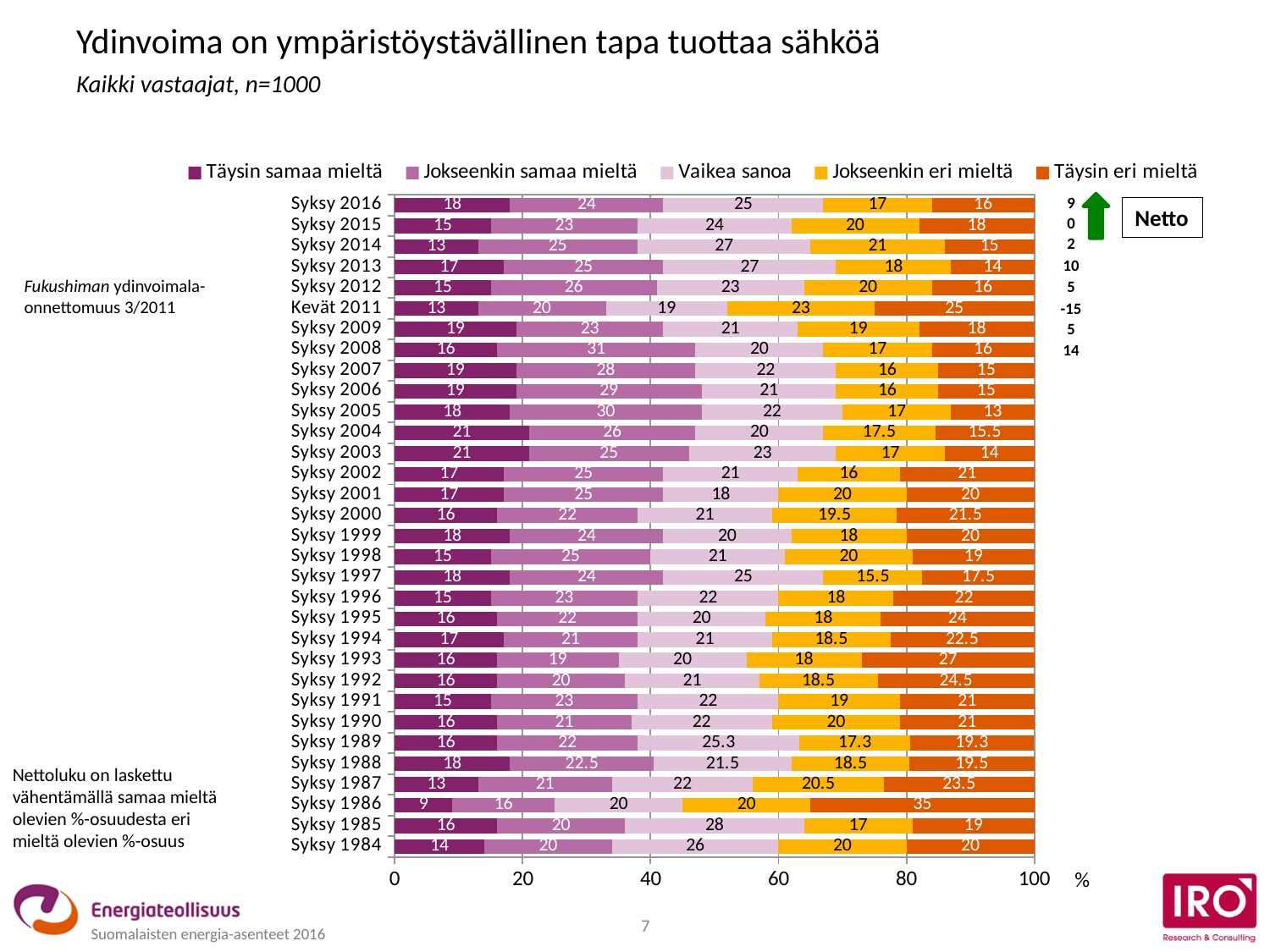
What is the difference between the "Jokseenkin samaa mieltä" values for Syksy 2008 and Syksy 2016? 7 How many categories (survey rounds) are shown on the y axis? 32 What is the title of the chart? Ydinvoima on ympäristöystävällinen tapa tuottaa sähköä What is the value of "Jokseenkin eri mieltä" for Kevät 2011? 23 Which is larger: the "Täysin eri mieltä" value for Syksy 2015 or for Syksy 2014? Syksy 2015 What kind of chart is shown on the slide? stacked bar chart What is the value of "Täysin samaa mieltä" for Syksy 2016? 18 What is the value of "Täysin eri mieltä" for Syksy 1986? 35 How many series does the legend list? 5 Which category has the lowest value for "Täysin samaa mieltä"? Syksy 1986 Which category has the highest value for "Täysin eri mieltä"? Syksy 1986 What is the value of "Vaikea sanoa" for Syksy 1989? 25.3